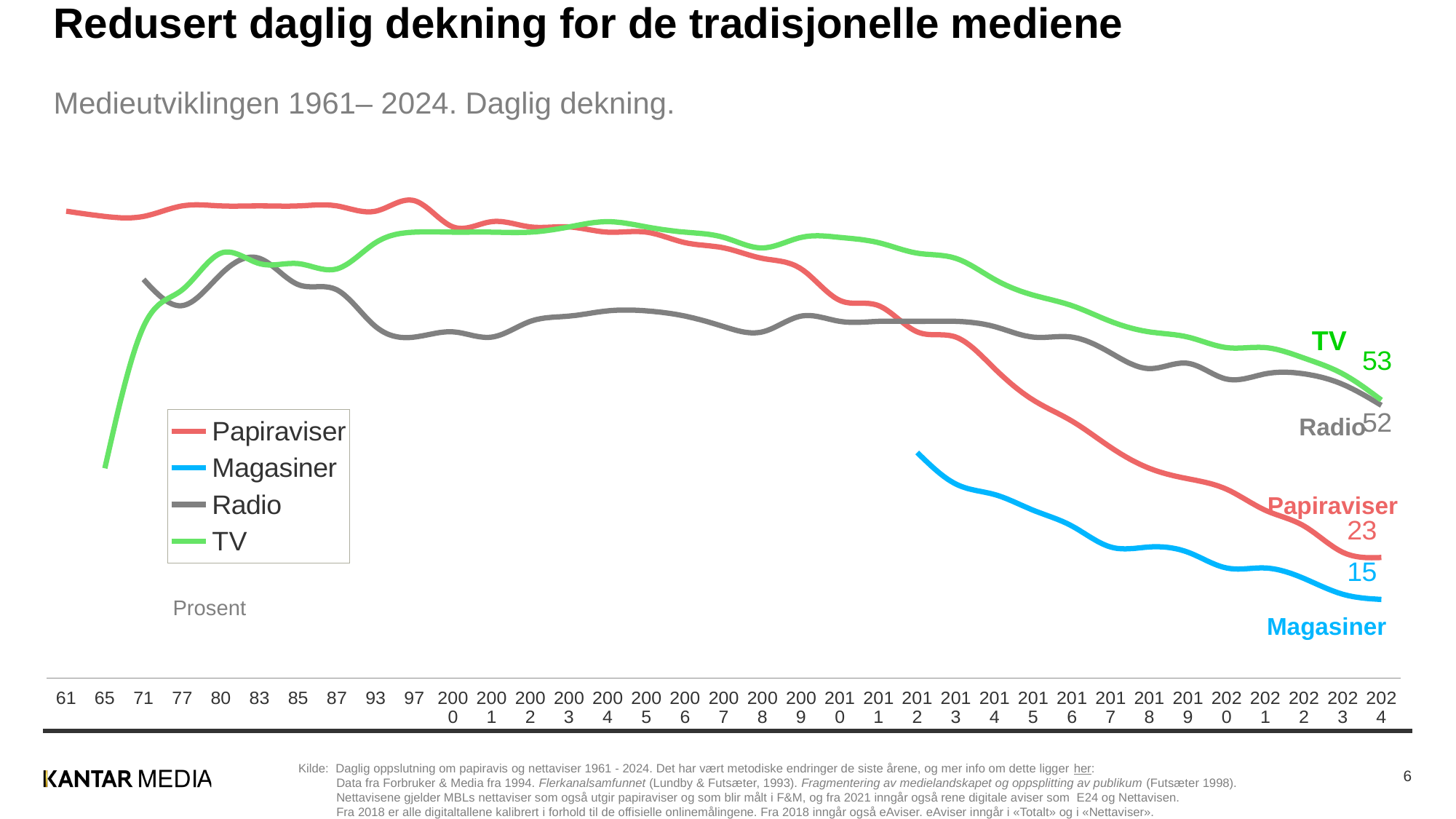
What is the daily coverage value shown for Magasiner in 2024? 15 In 2024, which is larger: the value for Radio or the value for Papiraviser? Radio What kind of chart is shown on the slide? Line chart How many series does the legend list? 4 What is the difference between the 2024 values for TV and Papiraviser? 30 Which series has the highest labelled value in 2024? TV What is the difference between the 2024 values for Papiraviser and Magasiner? 8 Which series has the lowest labelled value in 2024? Magasiner What is the daily coverage value shown for TV in 2024? 53 Does the Papiraviser line rise or fall from 2010 to 2024? Fall What is the daily coverage value shown for Radio in 2024? 52 What is the daily coverage value shown for Papiraviser in 2024? 23